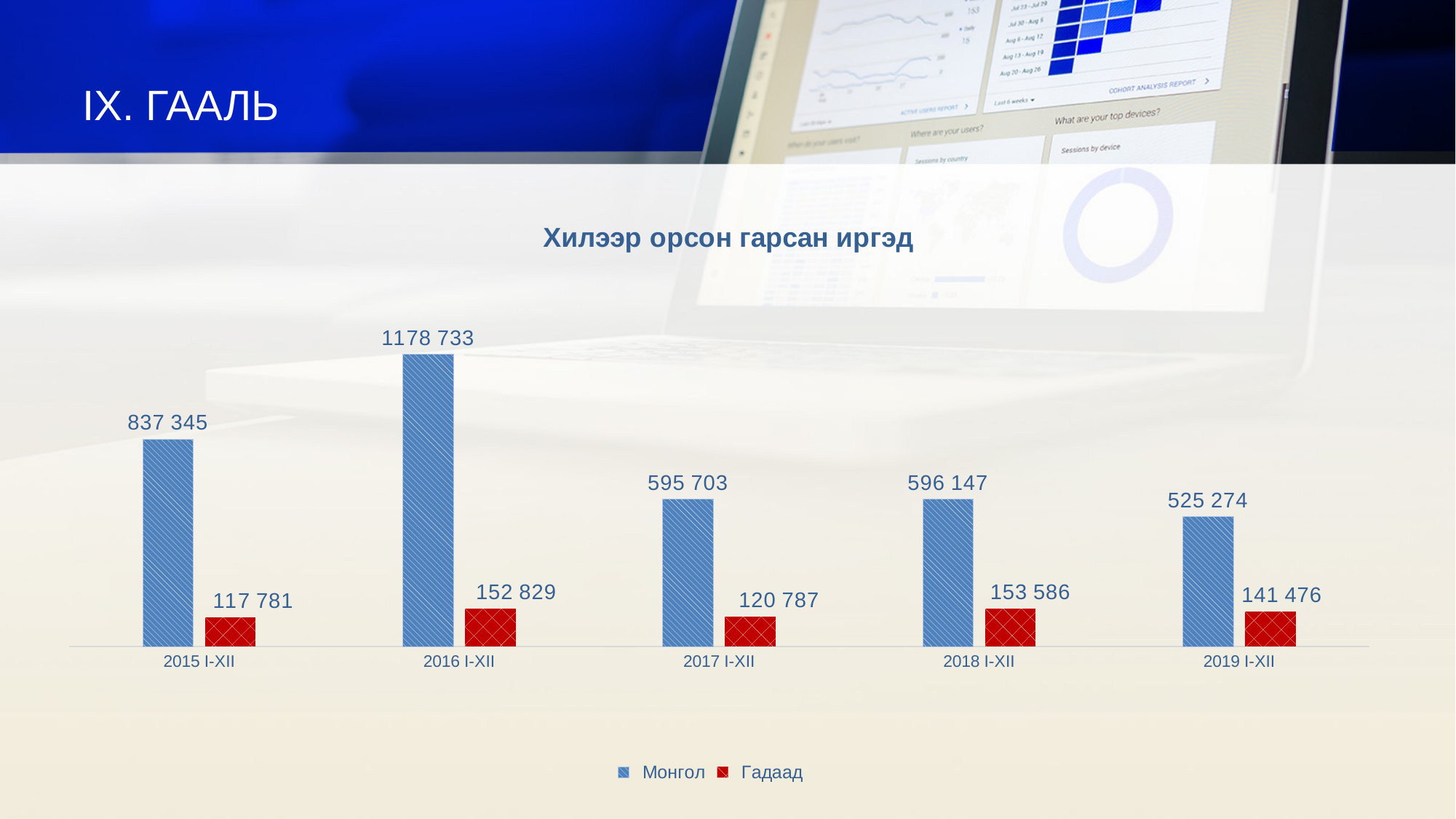
What is the value for Гадаад in 2017 I-XII? 120 787 How many periods are shown on the x axis? 5 How many series does the legend list? 2 In which period is the Гадаад value lowest? 2015 I-XII What is the difference between the Монгол values for 2016 I-XII and 2015 I-XII? 341 388 What is the title of the chart? Хилээр орсон гарсан иргэд What is the value for Монгол in 2015 I-XII? 837 345 What is the value for Гадаад in 2019 I-XII? 141 476 What is the value for Монгол in 2016 I-XII? 1178 733 Which is larger: the Гадаад value in 2018 I-XII or in 2017 I-XII? 2018 I-XII In which period is the Монгол value highest? 2016 I-XII In which period is the Монгол value lowest? 2019 I-XII